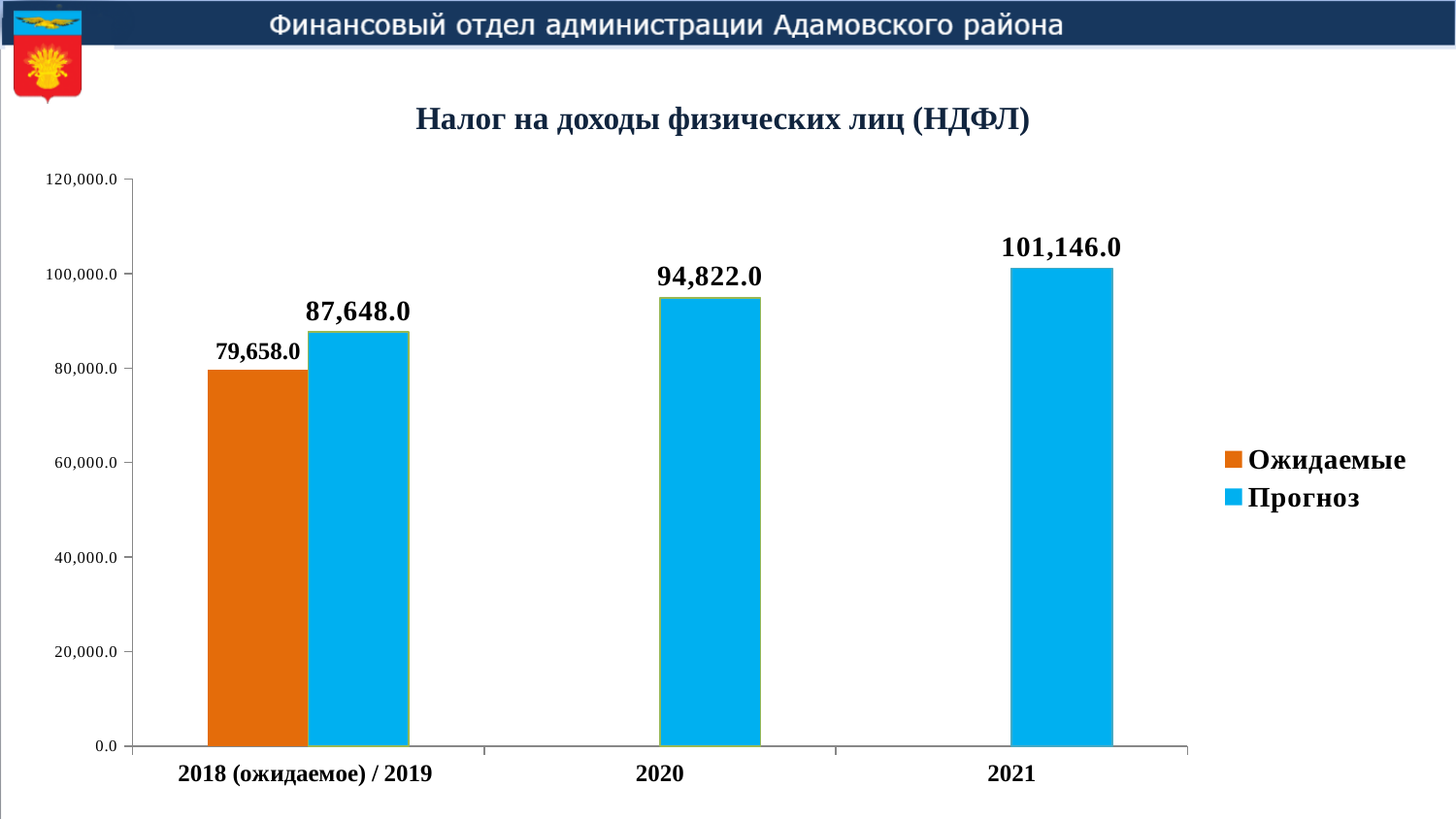
What is the value of the Прогноз series for 2020? 94,822.0 Which is larger: the Прогноз value for 2020 or the Прогноз value for 2021? 2021 What is the value of the Прогноз series for 2021? 101,146.0 What is the value of the Ожидаемые series in the 2018 (ожидаемое) / 2019 category? 79,658.0 Which category has the highest Прогноз value? 2021 What is the difference between the Прогноз and Ожидаемые values in the 2018 (ожидаемое) / 2019 category? 7,990.0 Do the Прогноз values rise or fall from 2019 to 2021? rise What is the value of the Прогноз series in the 2018 (ожидаемое) / 2019 category? 87,648.0 Is the Прогноз value for 2021 greater or less than 100,000.0? greater How many series does the legend list? 2 Which bar on the chart has the lowest value? Ожидаемые, 2018 (ожидаемое) / 2019 (79,658.0) What is the difference between the Прогноз values for 2021 and 2020? 6,324.0